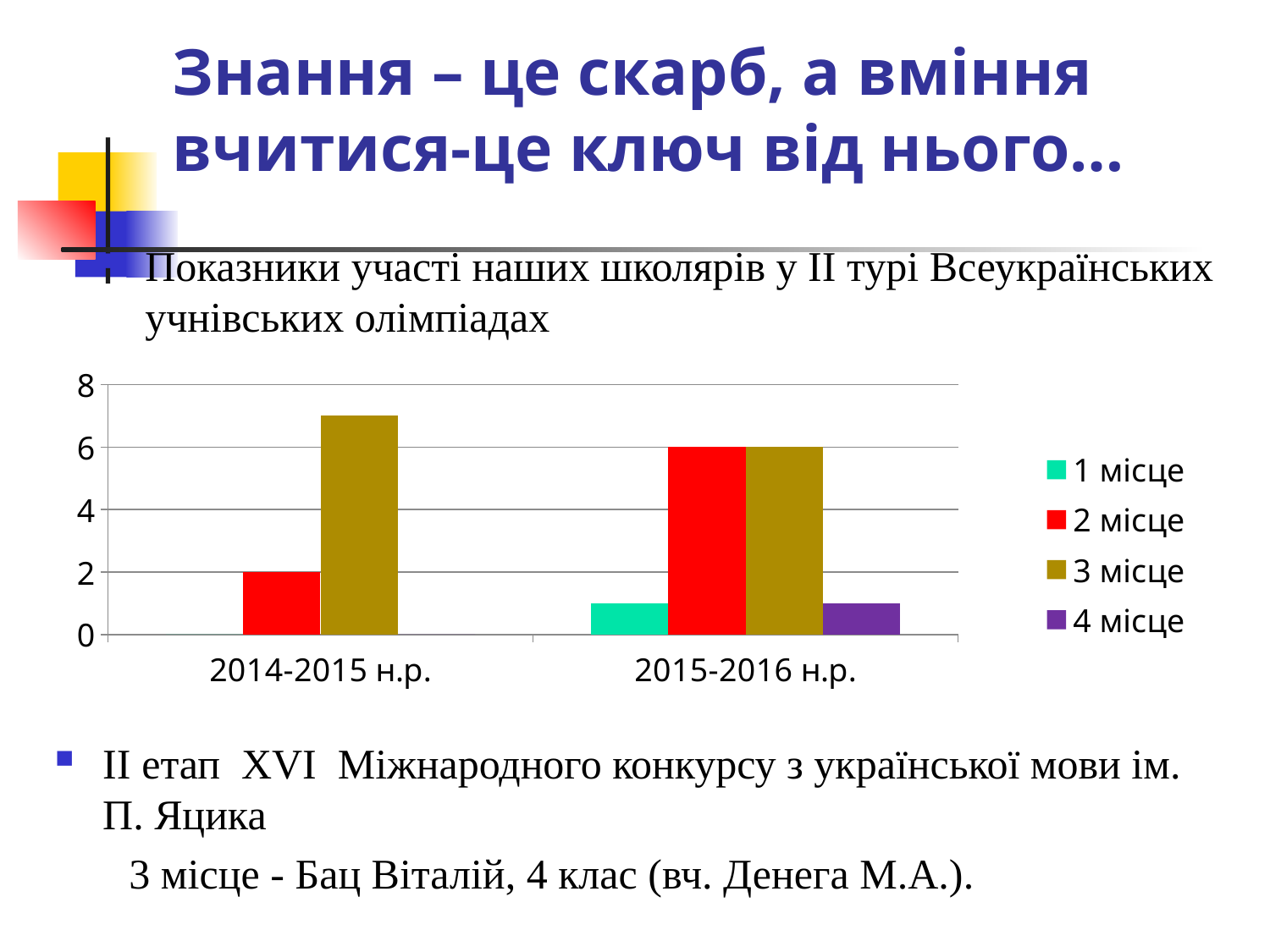
What kind of chart is shown on the slide? bar chart How many categories (school years) are shown on the x axis of the chart? 2 What is the value for 2 місце in 2014-2015 н.р.? 2 What is the value for 3 місце in 2015-2016 н.р.? 6 Which colour represents 4 місце in the chart legend? purple By how much did the value for 2 місце increase from 2014-2015 н.р. to 2015-2016 н.р.? 4 Which series has the highest value in 2014-2015 н.р.? 3 місце Is the value for 3 місце in 2014-2015 н.р. greater or less than 6? greater How many series does the chart legend list? 4 What is the value for 2 місце in 2015-2016 н.р.? 6 Is the value for 1 місце in 2015-2016 н.р. greater or less than 2? less Which is larger: the value for 2 місце in 2014-2015 н.р. or in 2015-2016 н.р.? 2015-2016 н.р.